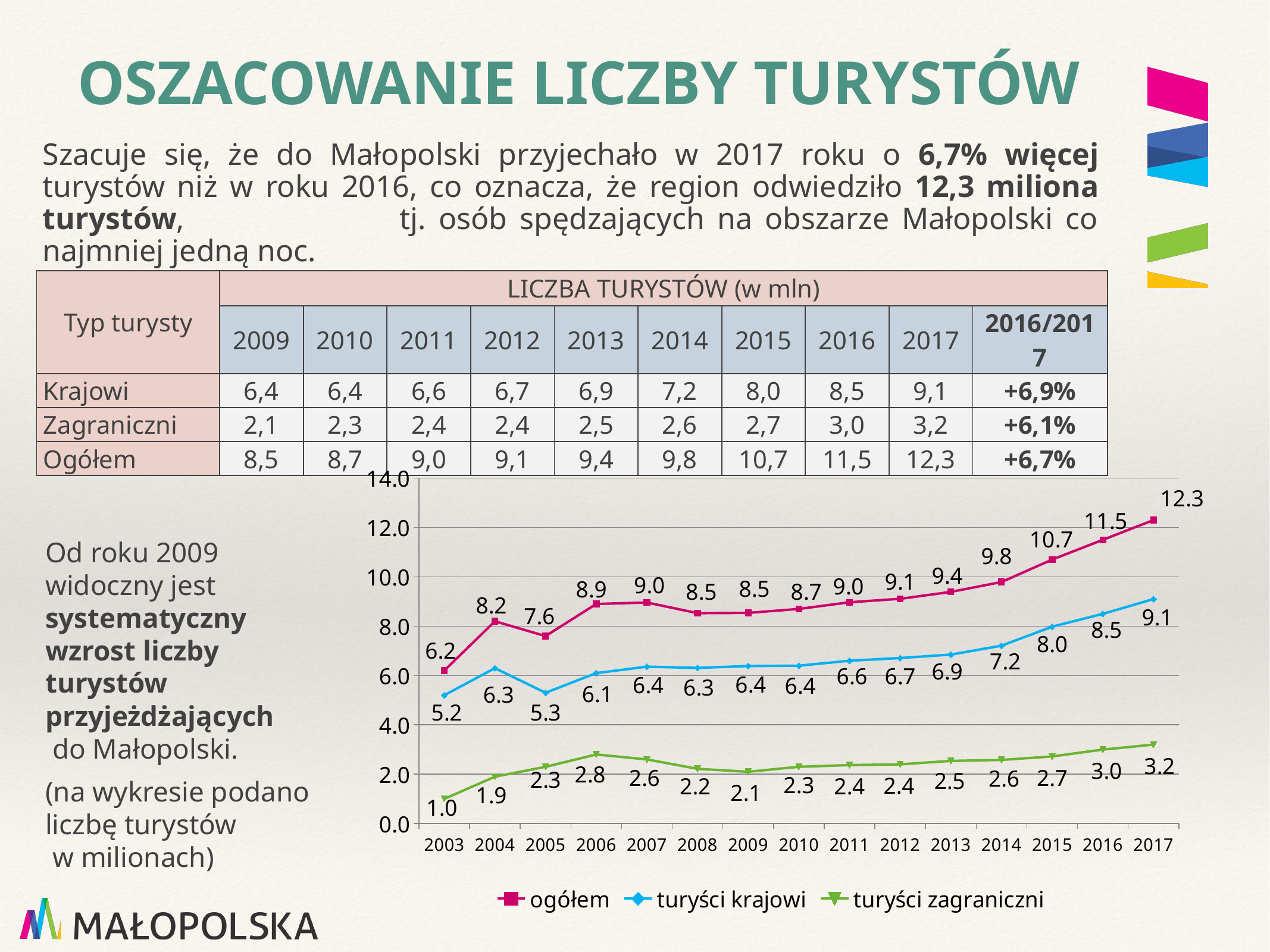
How many years are shown on the x axis of the chart? 15 What is the value of the turyści zagraniczni series in 2006? 2.8 What kind of chart is shown on the slide? line chart Does the ogółem series rise or fall from 2009 to 2017? rise Is the value of the turyści krajowi series in 2017 greater or less than 8.0? greater How many series does the chart legend list? 3 In which year is the turyści zagraniczni series at its highest? 2017 In which year is the ogółem series at its lowest? 2003 What is the difference between the ogółem values in 2017 and 2016? 0.8 Which is larger: the ogółem value in 2004 or in 2005? 2004 What is the value of the ogółem series in 2017? 12.3 What is the value of the turyści krajowi series in 2003? 5.2